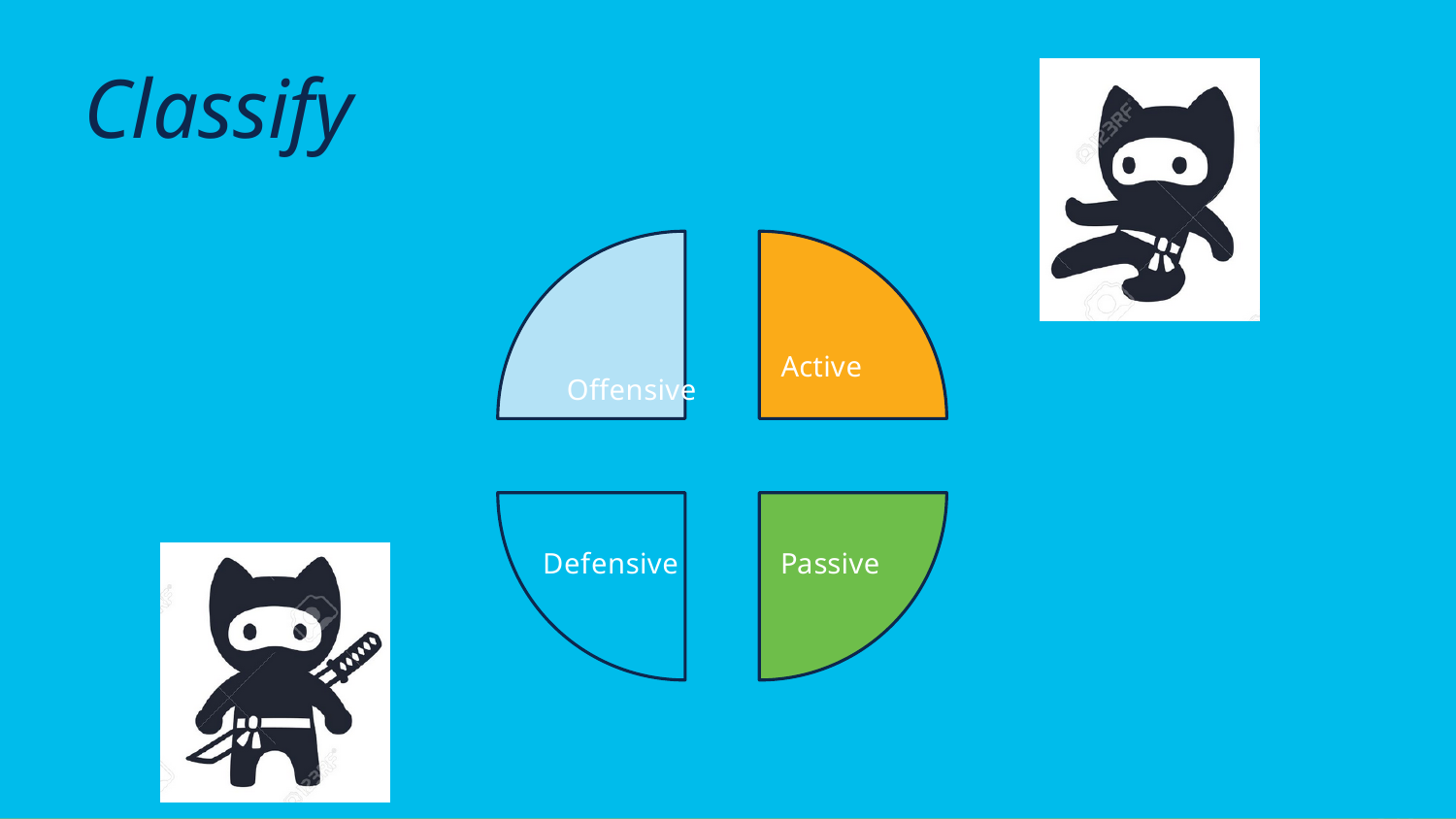
What label is on the bottom-left segment of the pie chart? Defensive What label is on the top-left segment of the pie chart? Offensive Which segment of the pie chart is coloured green? Passive Which segment of the pie chart is coloured orange? Active What kind of chart is shown in the centre of the slide? pie chart What label is on the top-right segment of the pie chart? Active How many segments does the circular diagram on the slide have? 4 What is the title of the slide containing the four-segment pie chart? Classify What label is on the bottom-right segment of the pie chart? Passive